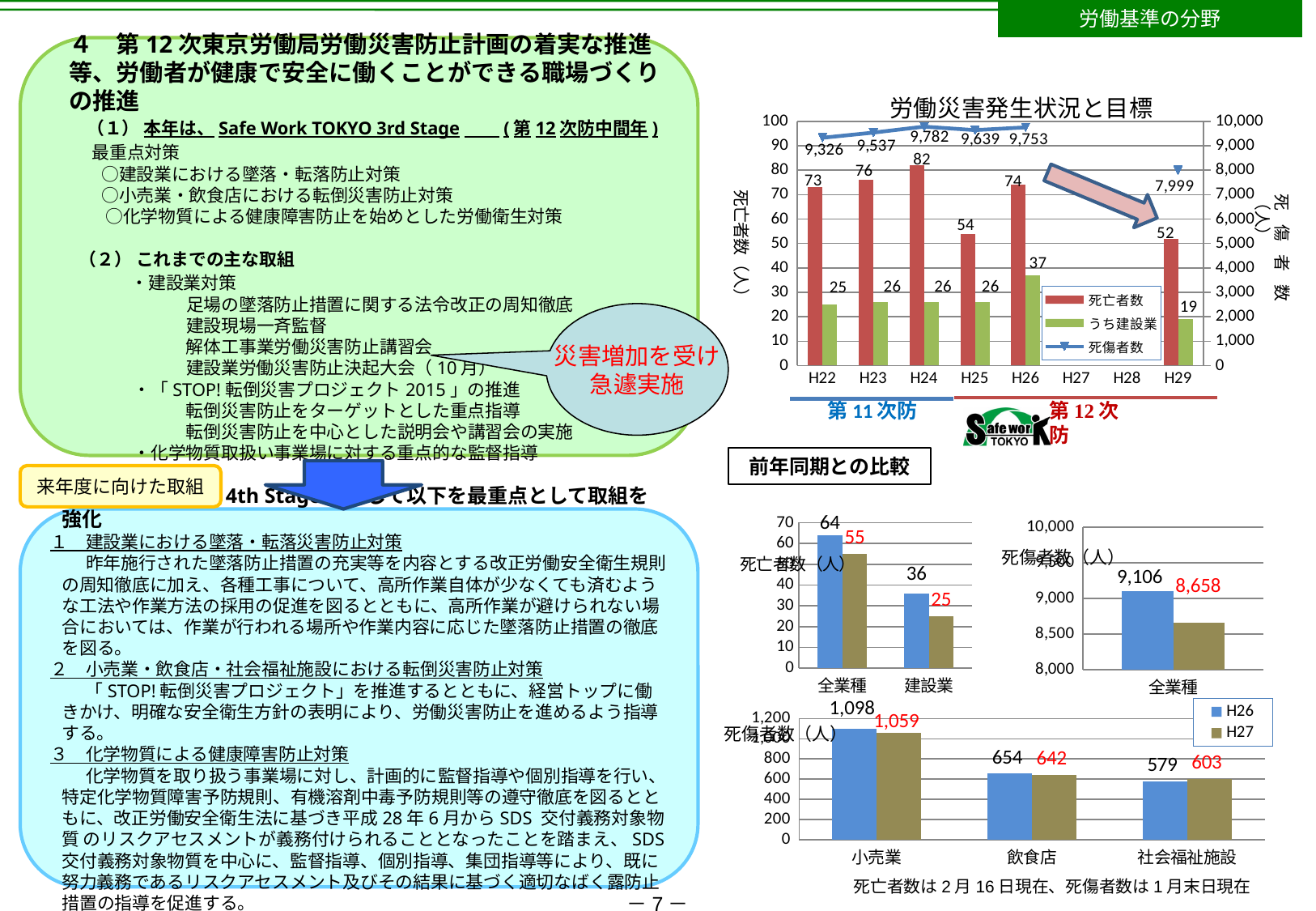
In the chart titled 労働災害発生状況と目標, how many series does the legend list? 3 In the chart titled 労働災害発生状況と目標, what is the value of うち建設業 for H26? 37 In the chart titled 労働災害発生状況と目標, what is the value of 死傷者数 for H29? 7,999 In the bottom 死傷者数（人） chart by industry, what is the H27 value for 飲食店? 642 In the chart titled 労働災害発生状況と目標, which year has the highest 死亡者数? H24 In the 死亡者数（人） comparison chart below 前年同期との比較, what is the difference between the H26 and H27 values for 全業種? 9 In the 死傷者数（人） chart showing only 全業種, what is the H26 value? 9,106 In the bottom 死傷者数（人） chart by industry, which is larger for 社会福祉施設, the H26 value or the H27 value? H27 In the 死亡者数（人） comparison chart below 前年同期との比較, what is the H27 value for 建設業? 25 What type of chart is the bottom 死傷者数（人） chart by industry? bar chart In the chart titled 労働災害発生状況と目標, what is the difference between 死亡者数 for H26 and H25? 20 In the chart titled 労働災害発生状況と目標, what is the value of 死亡者数 for H24? 82